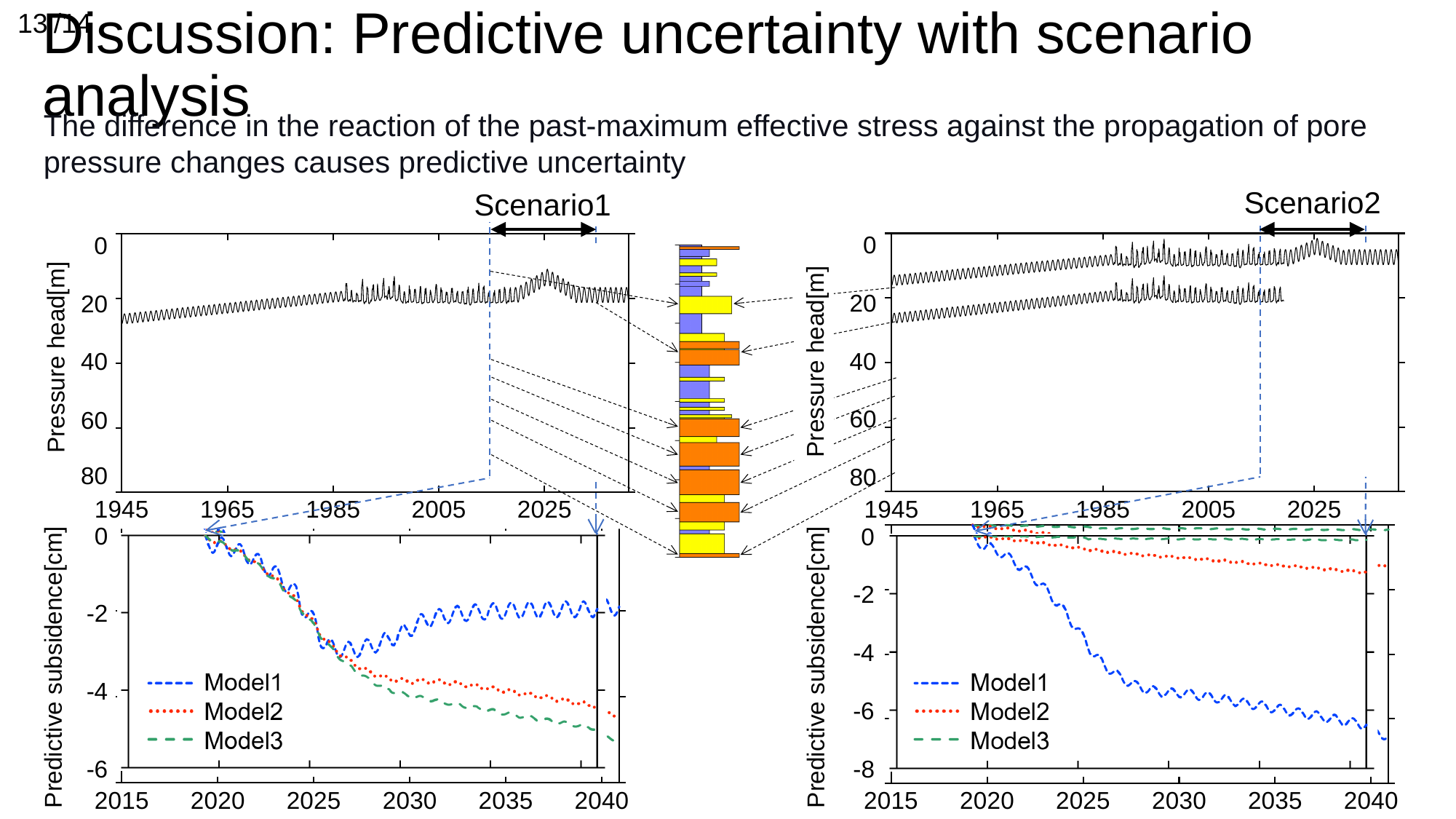
In the bottom-left predictive subsidence chart, which model shows the smallest (least negative) subsidence at 2040? Model1 In the bottom-right predictive subsidence chart, which model shows the largest (most negative) subsidence at 2040? Model1 In the bottom-left predictive subsidence chart, which model shows the largest (most negative) subsidence at 2040? Model3 In the bottom-right predictive subsidence chart, is the value for Model3 at 2040 greater or less than -2? greater What kind of chart is the bottom-left chart (Predictive subsidence, Scenario1)? line chart In the bottom-right predictive subsidence chart, which is larger (less negative) at 2040: Model2 or Model1? Model2 Which scenario label appears above the top-right pressure head chart? Scenario2 In the bottom-right predictive subsidence chart, is the value for Model1 at 2040 greater or less than -6? less What is the y-axis label of the top-left chart? Pressure head[m] In the bottom-left predictive subsidence chart, is the value for Model1 at 2040 greater or less than -4? greater How many series does the legend of the bottom-left predictive subsidence chart list? 3